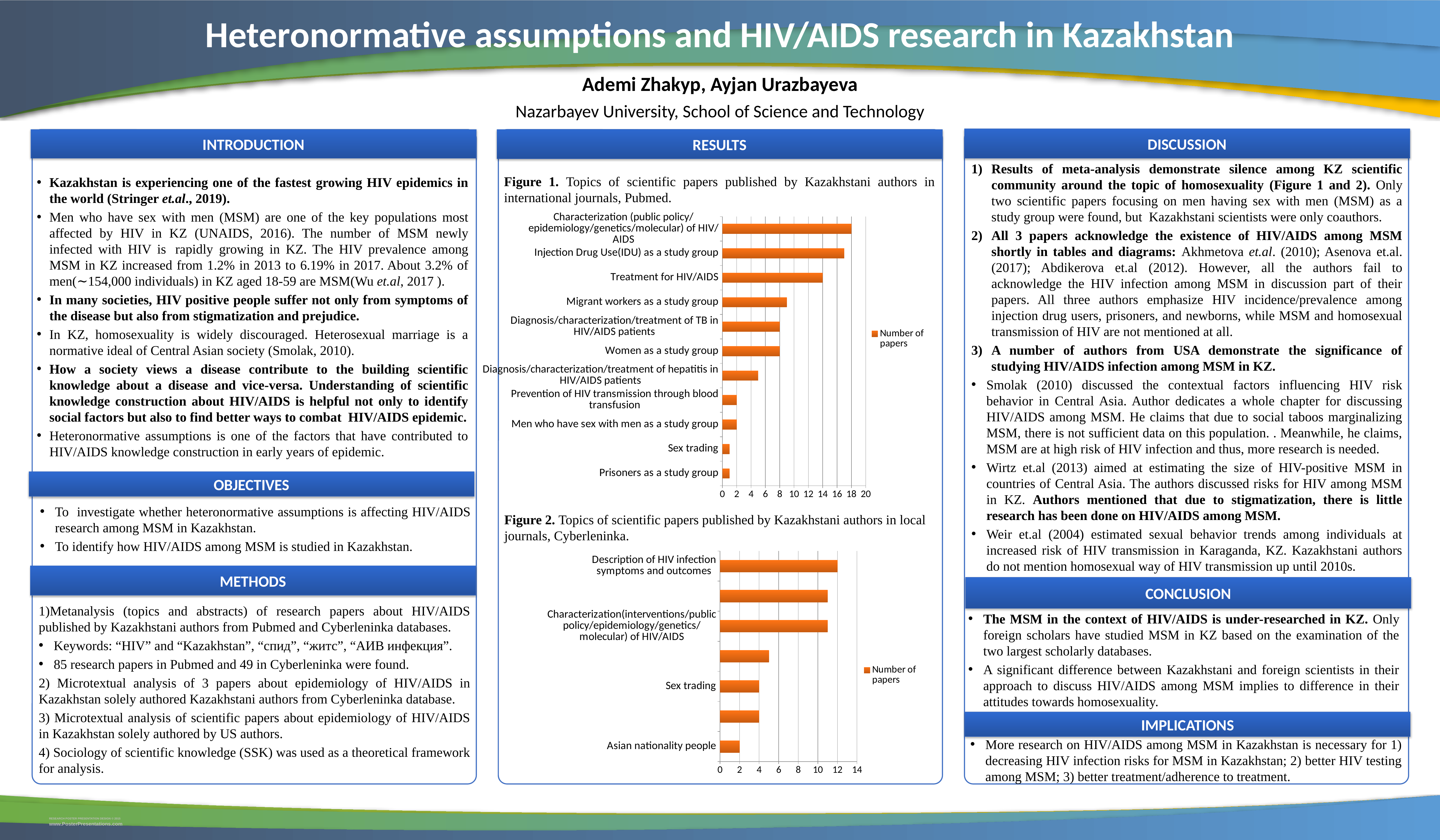
In Figure 1 (Pubmed topics), is the value for Treatment for HIV/AIDS greater or less than 10? greater In Figure 1 (Pubmed topics), how many series does the legend list? 1 In Figure 1 (Pubmed topics), how many topic categories are plotted? 11 In Figure 1 (Pubmed topics), which topic has the highest number of papers? Characterization (public policy/epidemiology/genetics/molecular) of HIV/AIDS In Figure 2 (Cyberleninka topics), how many bars are plotted? 7 In Figure 1 (Pubmed topics), is the value for Men who have sex with men as a study group greater or less than 4? less In Figure 2 (Cyberleninka topics), which labelled category has the lowest number of papers? Asian nationality people In Figure 1 (Pubmed topics), which has more papers: Treatment for HIV/AIDS or Women as a study group? Treatment for HIV/AIDS In Figure 2 (Cyberleninka topics), which has more papers: Description of HIV infection symptoms and outcomes or Asian nationality people? Description of HIV infection symptoms and outcomes In Figure 1 (Pubmed topics), what is the legend entry? Number of papers In Figure 1 (Pubmed topics), what kind of chart is used? bar chart In Figure 2 (Cyberleninka topics), is the value for Sex trading greater or less than 6? less